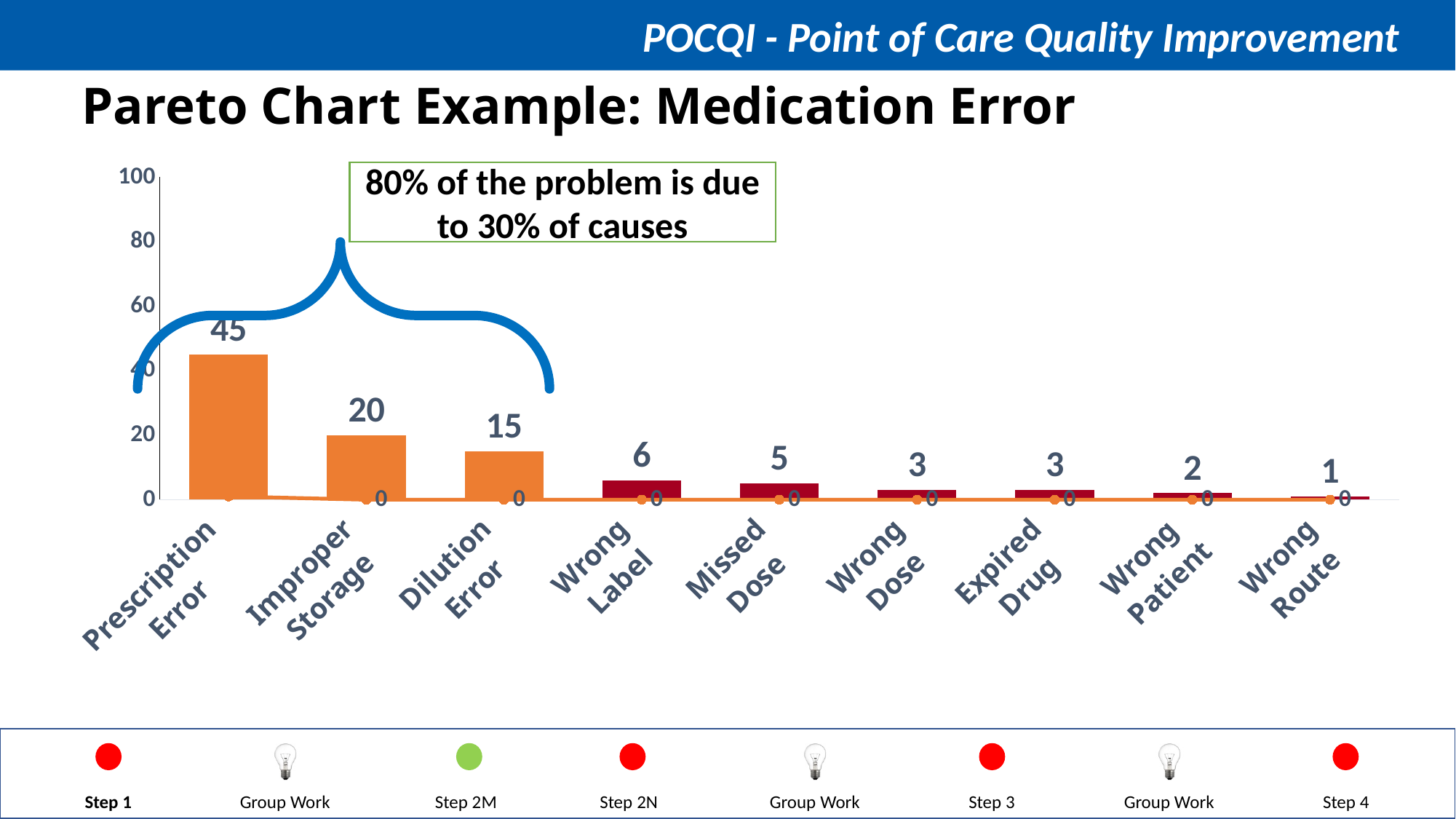
What is the value for Improper Storage? 20 What is the value for Prescription Error? 45 What is the difference between the values for Prescription Error and Improper Storage? 25 What kind of chart is shown on the slide? Bar chart (Pareto chart) Do the bar values rise or fall from left to right along the x axis? Fall Which category has the lowest value? Wrong Route What is the value for Missed Dose? 5 What is the value for Dilution Error? 15 What does the text in the green box above the chart say? 80% of the problem is due to 30% of causes Which is larger, the value for Wrong Label or the value for Wrong Patient? Wrong Label How many categories are shown on the x axis? 9 Which category has the highest value? Prescription Error